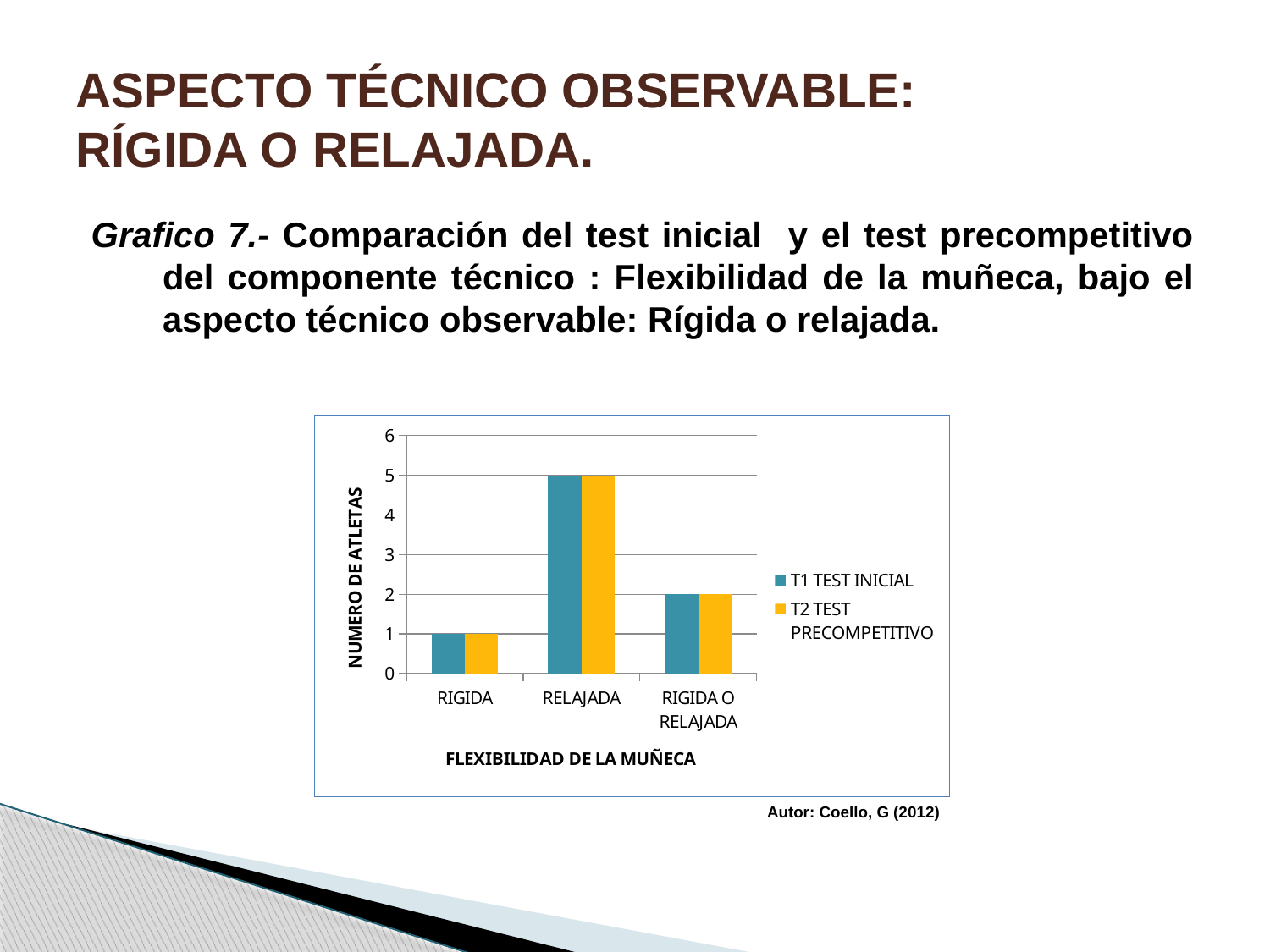
What is the value for RIGIDA in the T2 TEST PRECOMPETITIVO series? 1 What is the value for RIGIDA O RELAJADA in the T1 TEST INICIAL series? 2 Which category has the highest value in the T2 TEST PRECOMPETITIVO series? RELAJADA How many series does the chart's legend list? 2 Which is larger in the T2 TEST PRECOMPETITIVO series: RIGIDA O RELAJADA or RIGIDA? RIGIDA O RELAJADA How many categories are shown on the x axis of the chart? 3 What is the label of the chart's y axis? NUMERO DE ATLETAS What kind of chart is shown on the slide? bar chart What is the label of the chart's x axis? FLEXIBILIDAD DE LA MUÑECA What is the difference between the T1 TEST INICIAL values for RELAJADA and RIGIDA O RELAJADA? 3 What is the value for RELAJADA in the T1 TEST INICIAL series? 5 Which category has the lowest value in the T1 TEST INICIAL series? RIGIDA